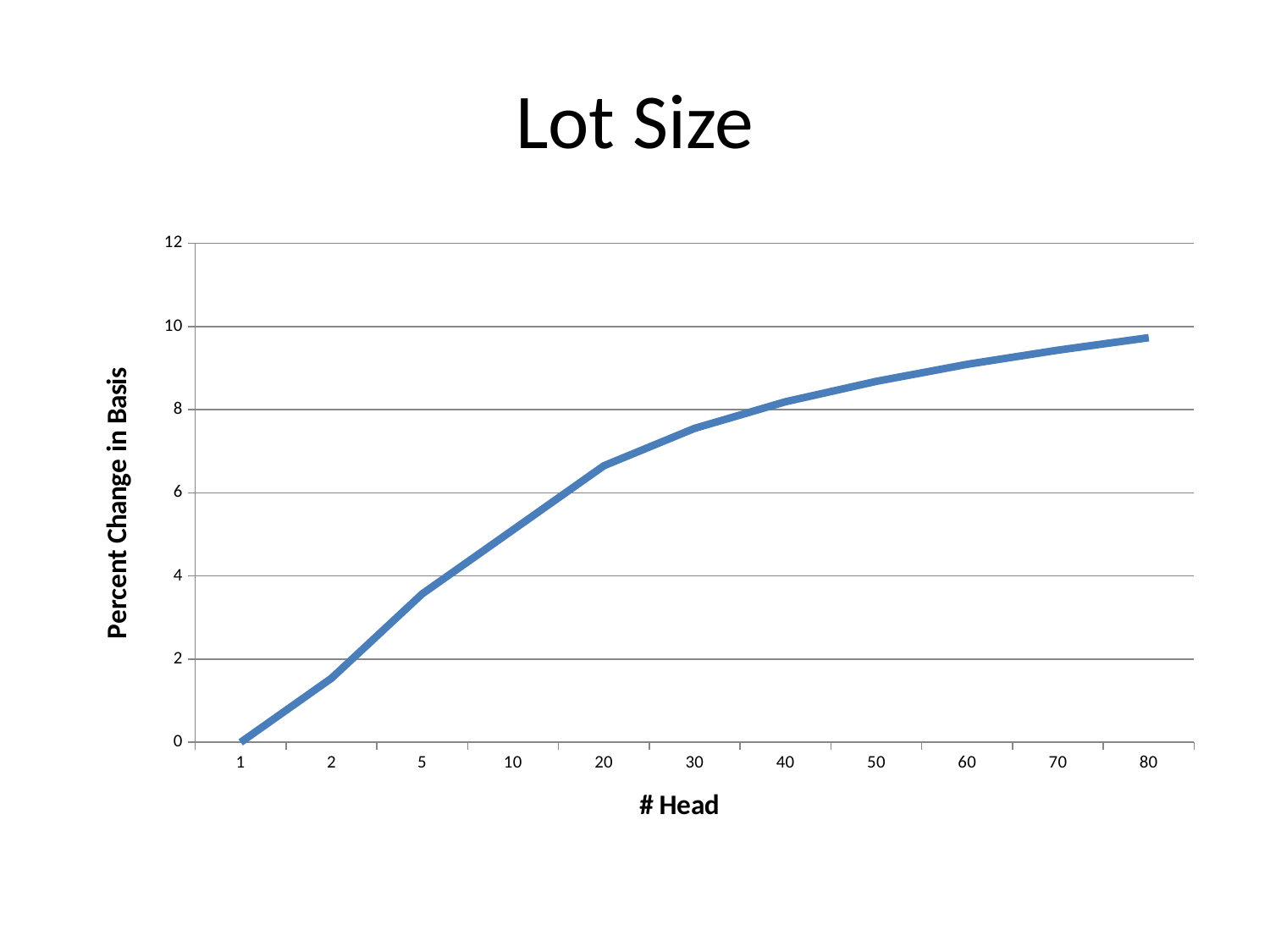
Which # Head category has the lowest Percent Change in Basis? 1 Which has a larger Percent Change in Basis, 10 head or 50 head? 50 Which # Head category has the highest Percent Change in Basis? 80 What is the label of the y axis? Percent Change in Basis What is the title of the chart? Lot Size Is the value for 5 head greater or less than 4? less Do the values rise or fall as # Head increases along the x axis? rise What is the Percent Change in Basis at 1 head? 0 How many # Head categories are plotted along the x axis? 11 Is the value for 80 head greater or less than 10? less Is the value for 20 head greater or less than 6? greater What kind of chart is shown on the slide? line chart